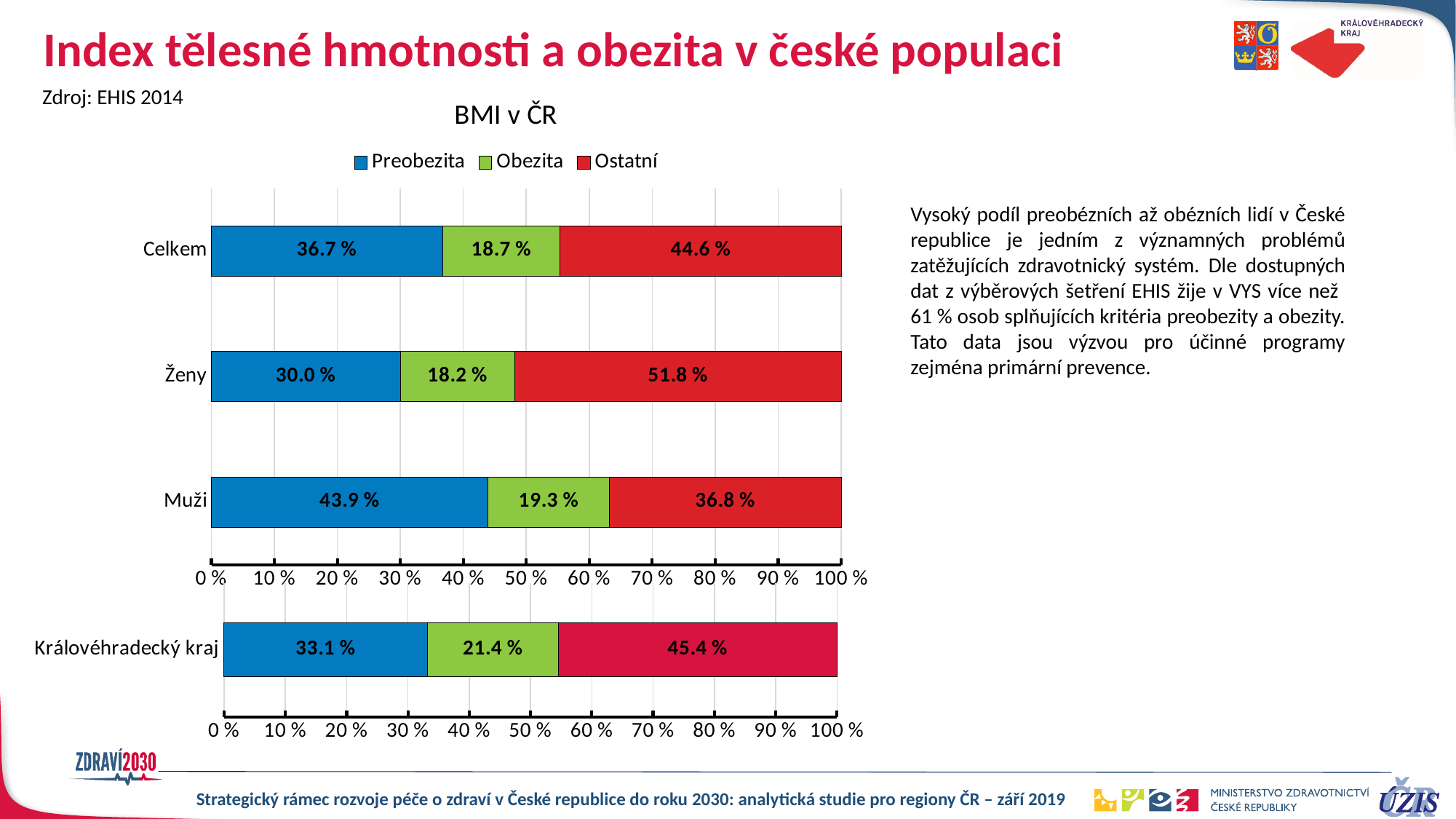
In the BMI v ČR chart, what is the Preobezita value for Celkem? 36.7 % In the BMI v ČR chart, what is the difference between the Preobezita values for Muži and Ženy? 13.9 % What kind of chart is the BMI v ČR chart? Stacked bar chart In the BMI v ČR chart, which category has the lowest Ostatní value? Muži In the BMI v ČR chart, what is the Ostatní value for Ženy? 51.8 % In the bottom chart, what is the Obezita value for Královéhradecký kraj? 21.4 % In the BMI v ČR chart, which category has the highest Preobezita value? Muži In the BMI v ČR chart, what is the Obezita value for Muži? 19.3 % How many series does the legend of the BMI v ČR chart list? 3 In the BMI v ČR chart, which is larger: the Ostatní value for Celkem or for Ženy? Ženy In the bottom chart, what is the total of the Preobezita and Obezita values for Královéhradecký kraj? 54.5 % How many categories are shown in the BMI v ČR chart? 3